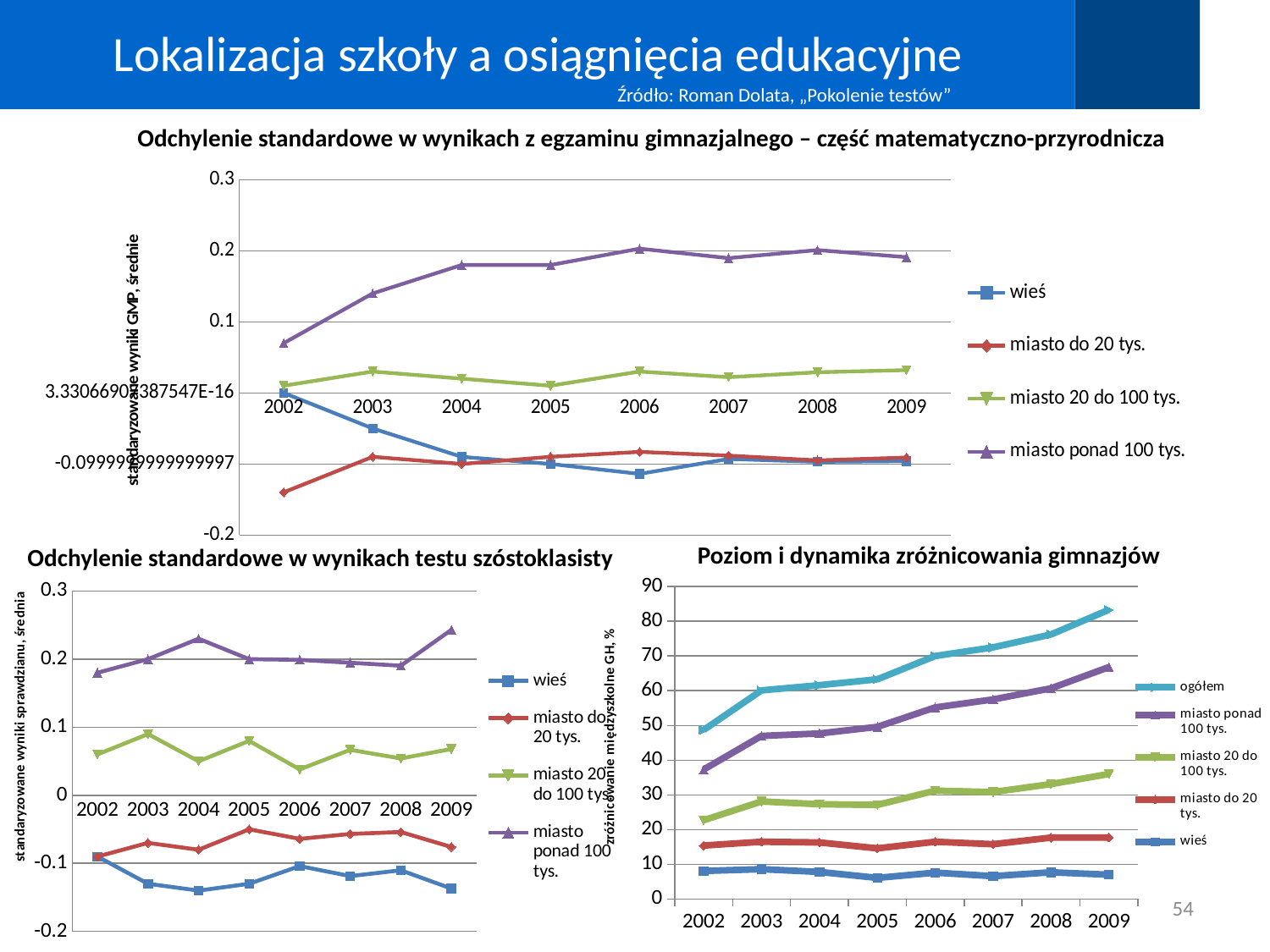
In the top chart (egzamin gimnazjalny), which series has the highest value in 2009? miasto ponad 100 tys. In the bottom-left chart (test szóstoklasisty), which series has the lowest value in 2004? wieś In the bottom-right chart 'Poziom i dynamika zróżnicowania gimnazjów', which is larger in 2009: 'ogółem' or 'wieś'? ogółem In the top chart (egzamin gimnazjalny), does the 'miasto ponad 100 tys.' line rise or fall from 2002 to 2004? rise In the top chart (egzamin gimnazjalny), is the value for 'miasto ponad 100 tys.' in 2006 greater or less than 0.1? greater In the bottom-left chart (test szóstoklasisty), is the value for 'wieś' in 2004 greater or less than -0.1? less In the top chart (egzamin gimnazjalny), how many series does the legend list? 4 In the bottom-right chart 'Poziom i dynamika zróżnicowania gimnazjów', how many series does the legend list? 5 In the bottom-left chart (test szóstoklasisty), is the value for 'miasto ponad 100 tys.' in 2004 greater or less than 0.2? greater In the top chart (egzamin gimnazjalny), how many years are plotted on the x axis? 8 What type of chart is the top chart titled 'Odchylenie standardowe w wynikach z egzaminu gimnazjalnego – część matematyczno-przyrodnicza'? line chart